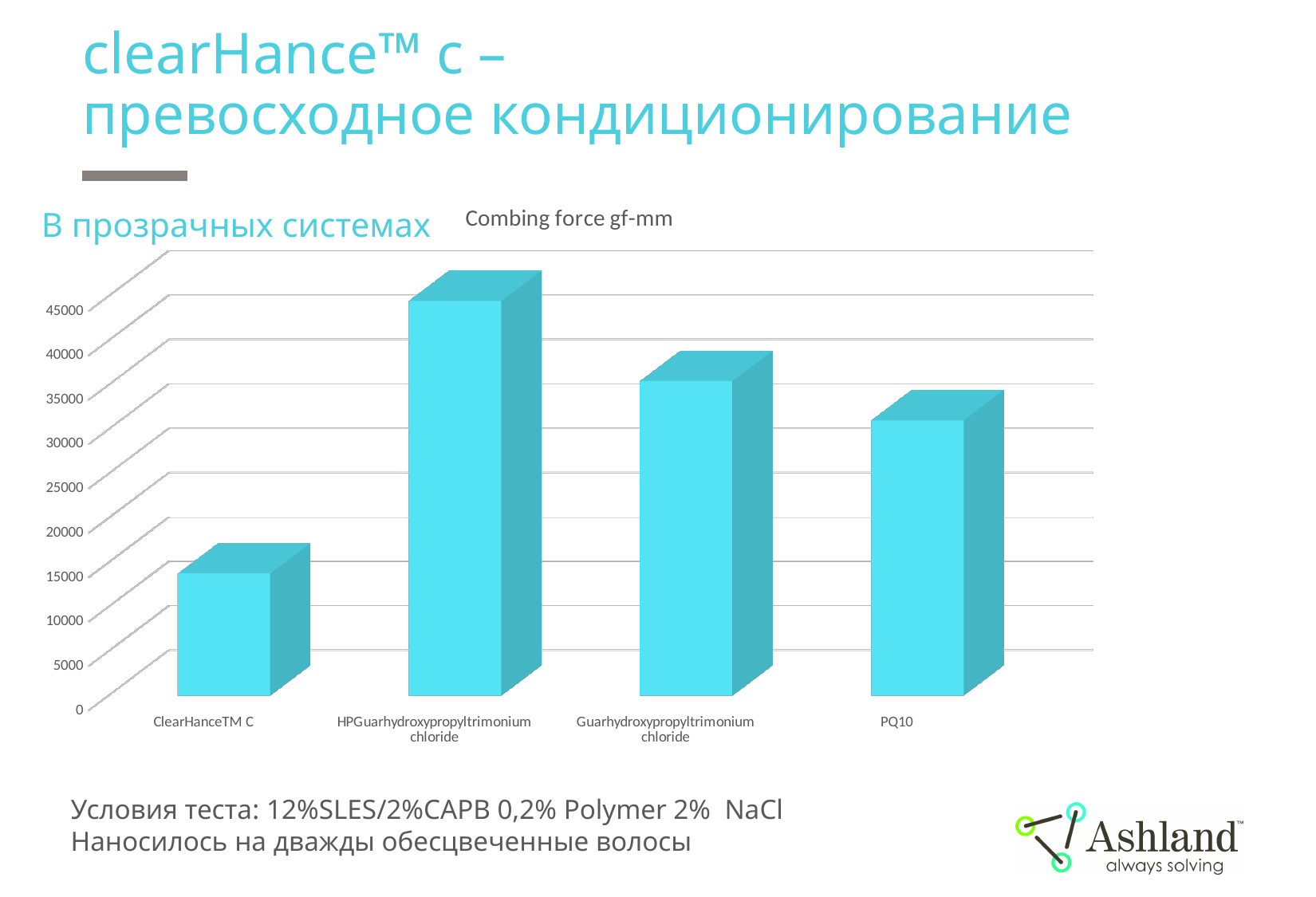
Is the value for ClearHanceTM C greater or less than 20000? less Is the value for Guarhydroxypropyltrimonium chloride greater or less than 30000? greater Which category has the highest combing force? HPGuarhydroxypropyltrimonium chloride How many categories are plotted in the chart? 4 Which has a larger combing force, Guarhydroxypropyltrimonium chloride or PQ10? Guarhydroxypropyltrimonium chloride Is the value for PQ10 greater or less than 40000? less What kind of chart is shown on the slide? bar chart Which has a larger combing force, ClearHanceTM C or PQ10? PQ10 What is the title of the chart? Combing force gf-mm Which category has the lowest combing force? ClearHanceTM C